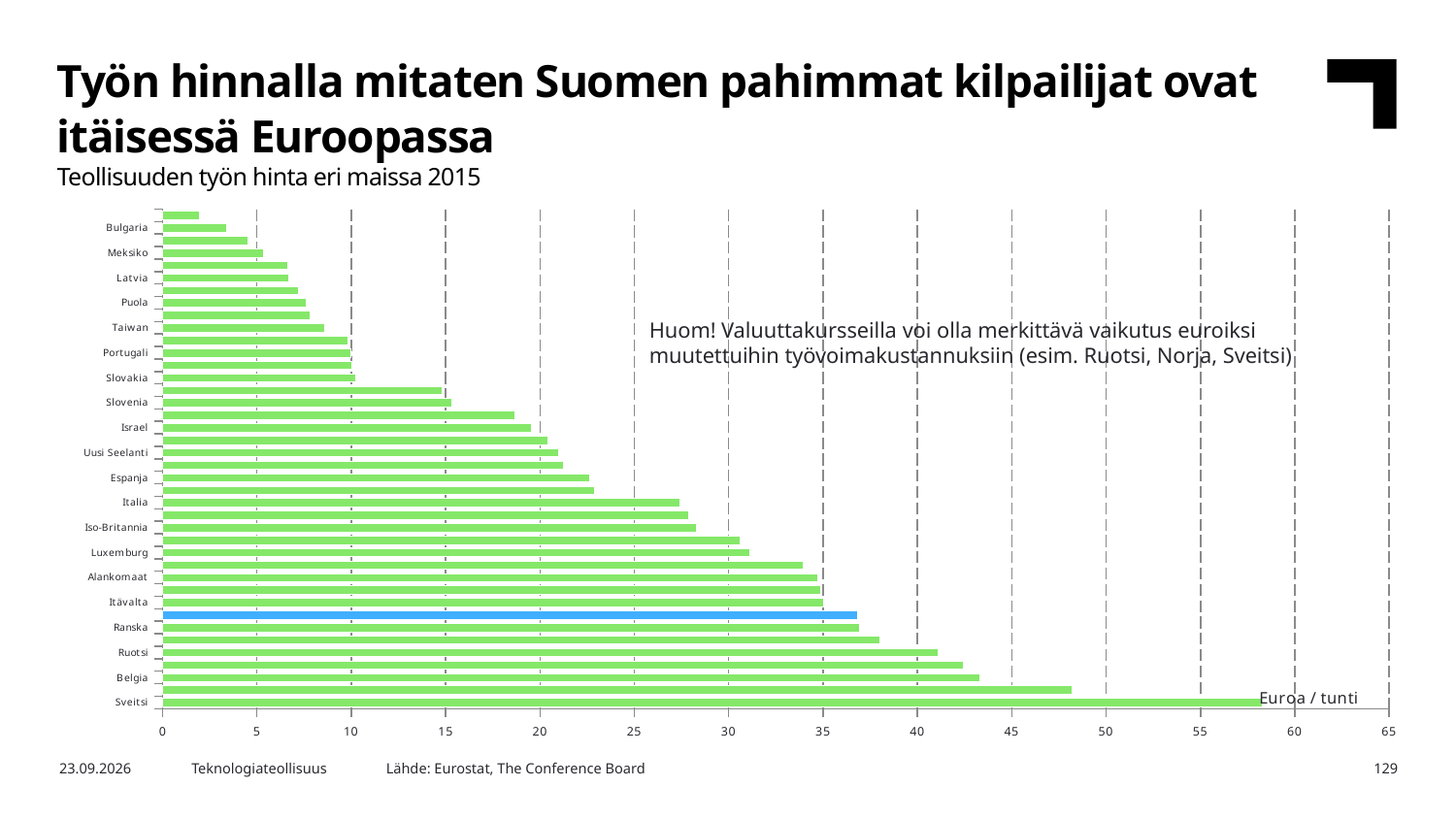
Do the bar values increase or decrease going from the top of the chart to the bottom? increase Is the value for Belgia greater or less than 40? greater What kind of chart is shown on the slide? bar chart Which has a higher value, Espanja or Italia? Italia Is the value for Sveitsi greater or less than 55? greater Is the value for Slovenia greater or less than 10? greater Which labeled country has the highest labour cost in the chart? Sveitsi Which has a higher value, Belgia or Ruotsi? Belgia What unit label is shown at the bottom right of the chart? Euroa / tunti